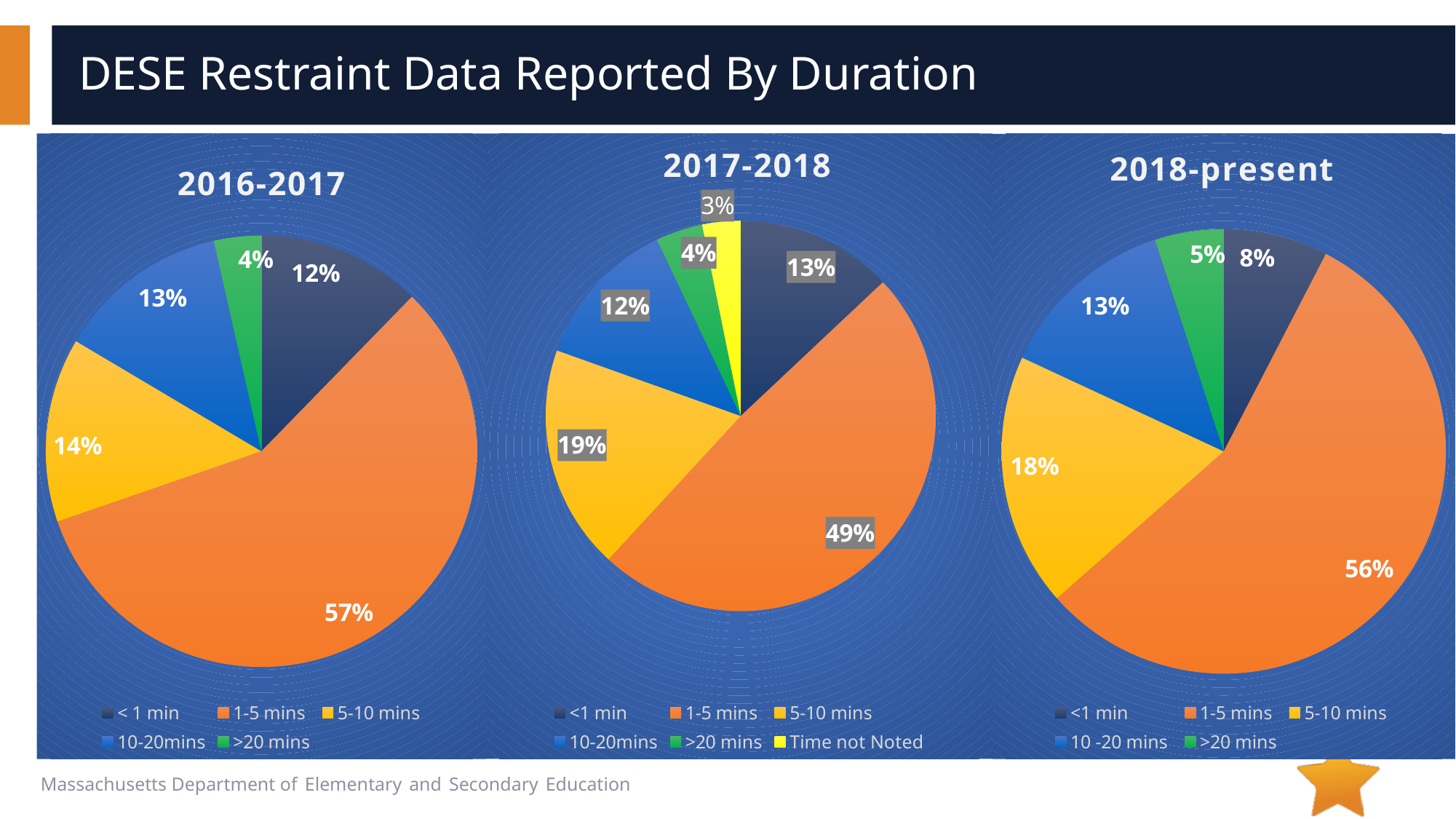
In the 2016-2017 pie chart, what is the difference between the 1-5 mins share and the 5-10 mins share? 43% Which category is shown in yellow in the 2017-2018 pie chart legend? Time not Noted What kind of chart is used for the 2018-present data? Pie chart In the 2016-2017 pie chart, what share is labelled for the 1-5 mins slice? 57% In the 2018-present pie chart, which is larger, the < 1 min slice or the 10-20 mins slice? 10-20 mins In the 2018-present pie chart, which category has the largest slice? 1-5 mins In the 2017-2018 pie chart, what is the combined share of the 10-20 mins and >20 mins slices? 16% In the 2017-2018 pie chart, which category has the smallest slice? Time not Noted In the 2018-present pie chart, what share is labelled for the 5-10 mins slice? 18% How many categories does the legend of the 2017-2018 pie chart list? 6 In the 2017-2018 pie chart, what share is labelled for the Time not Noted slice? 3% How many categories does the legend of the 2016-2017 pie chart list? 5